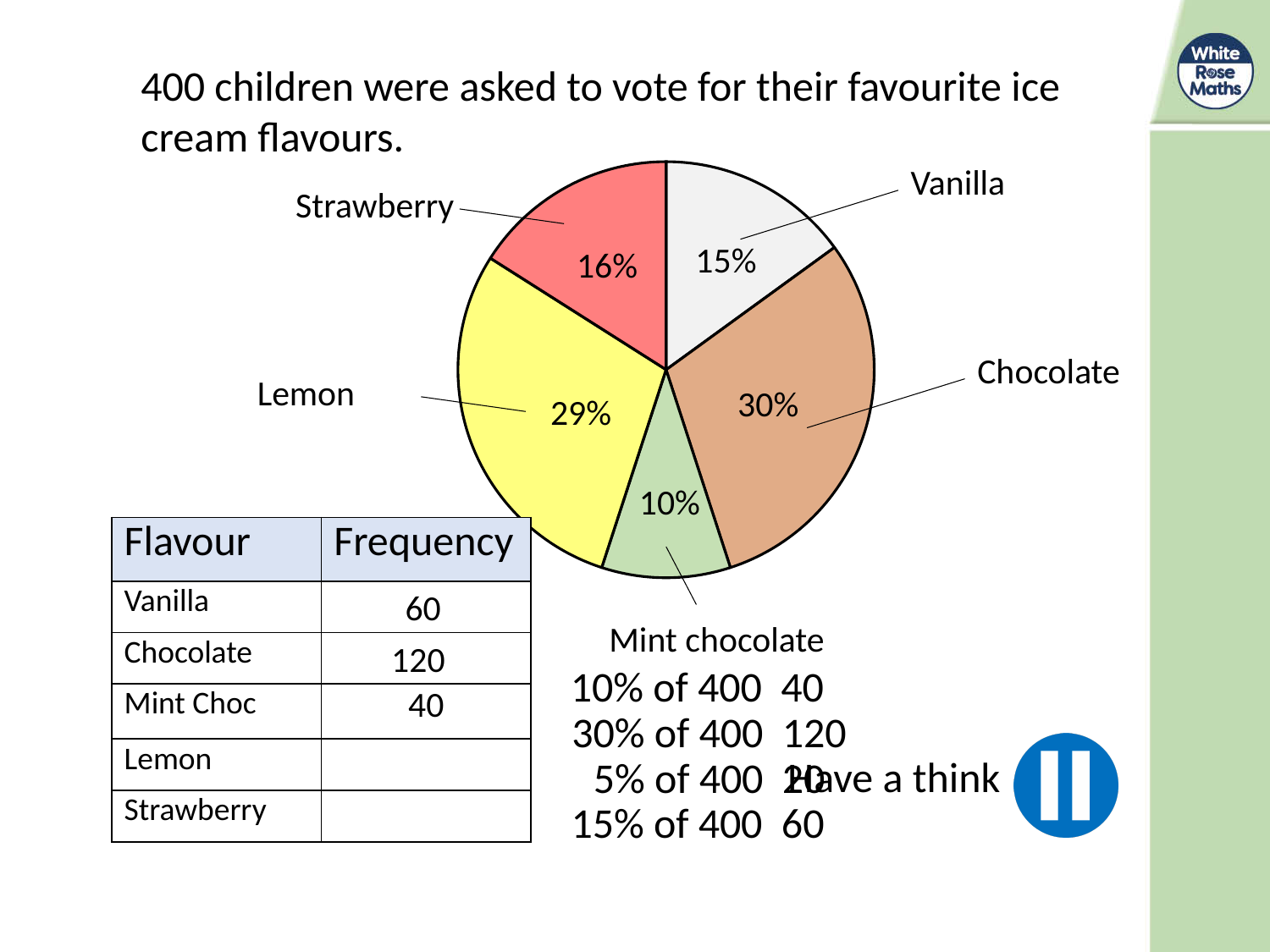
Which slice is larger, Strawberry or Vanilla? Strawberry Which flavour has the largest slice of the pie chart? Chocolate How many percentage points larger is the Chocolate slice than the Vanilla slice? 15 What colour is the Lemon slice in the pie chart? yellow What share of the pie chart does Mint chocolate take? 10% What percentage of the pie chart is Strawberry? 16% Which flavour has the smallest slice of the pie chart? Mint chocolate How many slices does the pie chart have? 5 What percentage of the pie chart is Lemon? 29% What percentage of the pie chart is Vanilla? 15% What kind of chart is shown on the slide? pie chart What percentage of the pie chart is Chocolate? 30%